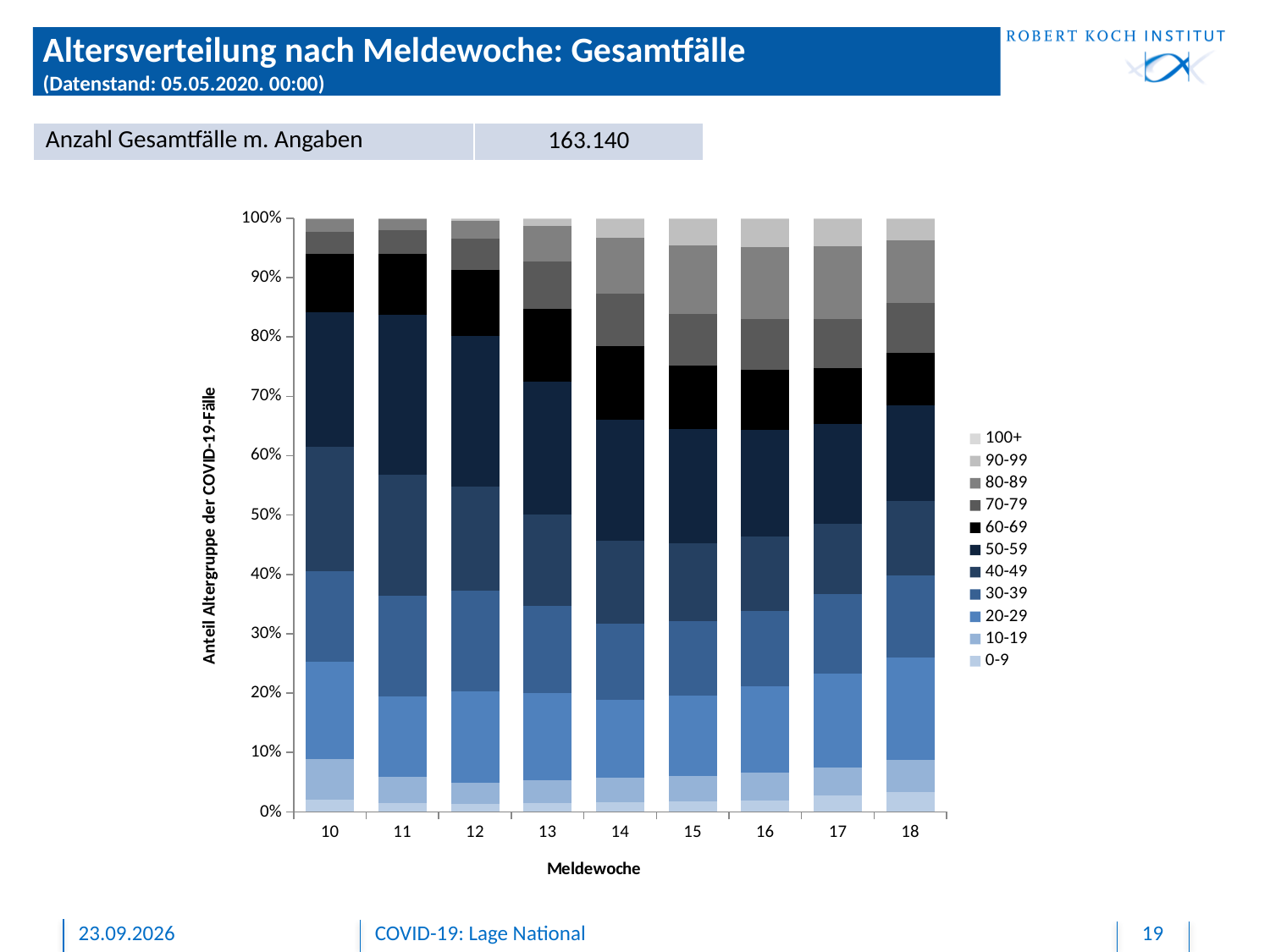
Is the share of the 80-89 age group in Meldewoche 10 greater or less than 10%? less How many reporting weeks (Meldewoche) are shown on the x axis of the chart? 9 Is the share of the 0-9 age group in Meldewoche 10 greater or less than 10%? less What kind of chart is shown on the slide? stacked bar chart Is the share of the 60-69 age group in Meldewoche 13 greater or less than 10%? greater What is the title of the chart on the slide? Altersverteilung nach Meldewoche: Gesamtfälle Which has the larger share of the 0-9 age group: Meldewoche 10 or Meldewoche 18? Meldewoche 18 Does the share of the 50-59 age group rise or fall from Meldewoche 10 to Meldewoche 18? fall How many age groups does the chart legend list? 11 Which has the larger share of the 80-89 age group: Meldewoche 10 or Meldewoche 18? Meldewoche 18 What is the label of the y axis of the chart? Anteil Altergruppe der COVID-19-Fälle